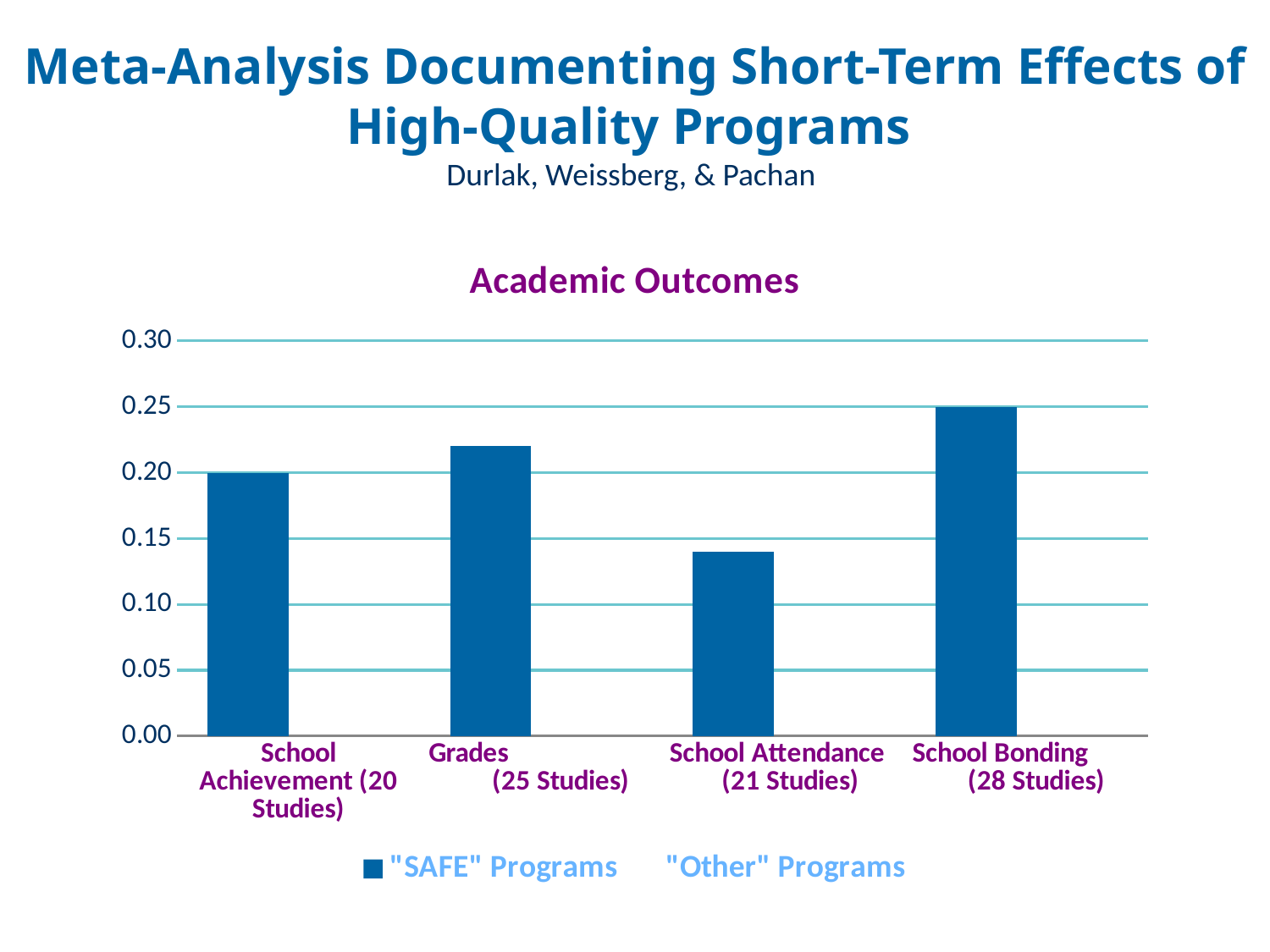
Which is larger, the value for Grades (25 Studies) or the value for School Attendance (21 Studies)? Grades (25 Studies) What kind of chart is shown on the slide? bar chart Is the value for School Attendance (21 Studies) greater or less than 0.15? less What is the title of the chart? Academic Outcomes What is the difference between the value for School Bonding (28 Studies) and the value for School Achievement (20 Studies)? 0.05 How many categories are shown on the x axis of the chart? 4 What is the value for School Bonding (28 Studies)? 0.25 Which category has the highest bar in the chart? School Bonding (28 Studies) What is the value for School Achievement (20 Studies)? 0.20 How many series does the chart's legend list? 2 Which category has the lowest bar in the chart? School Attendance (21 Studies) Is the value for Grades (25 Studies) greater or less than 0.20? greater